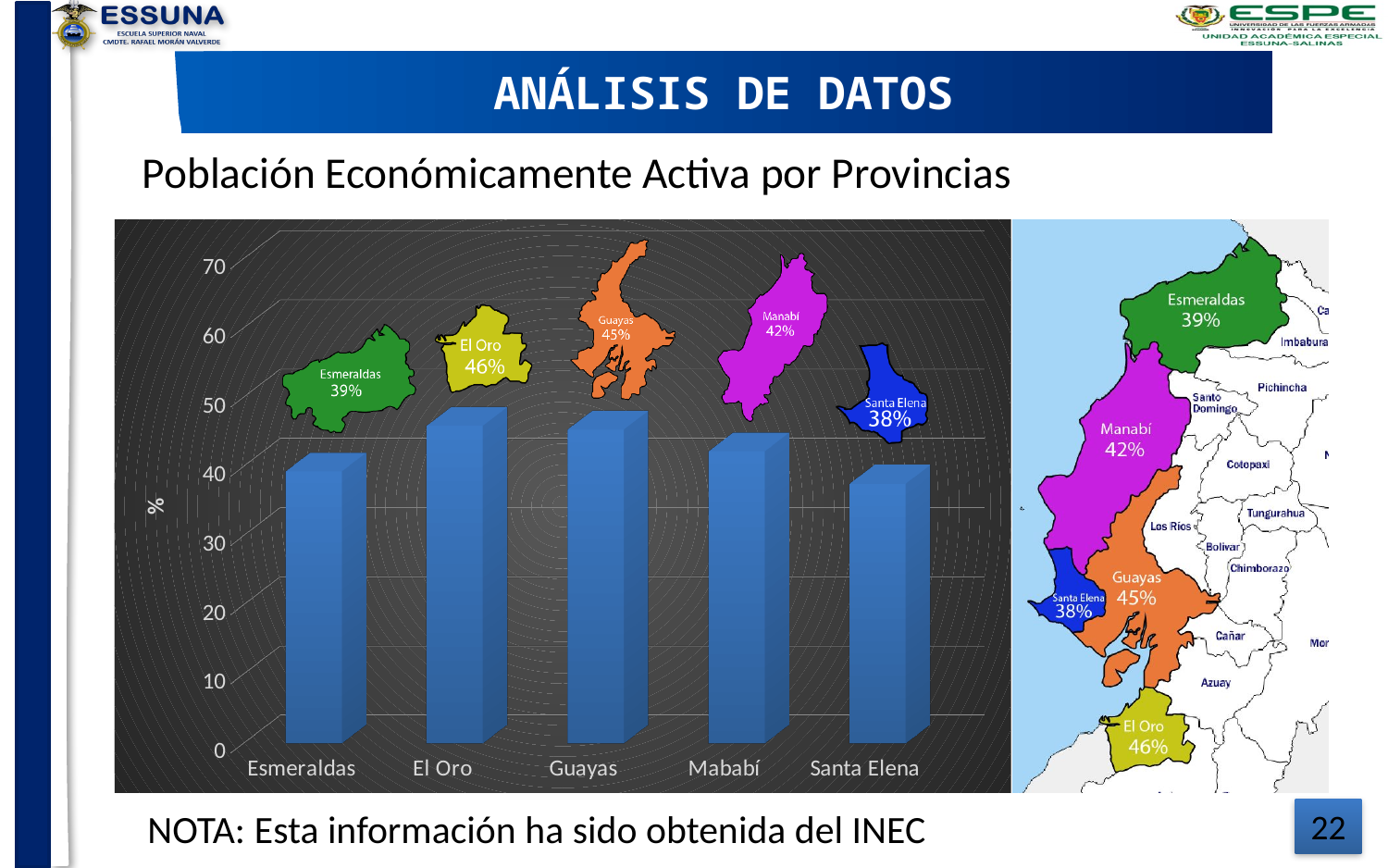
Is the value for Esmeraldas greater or less than 30? greater What is the value for Guayas? 45% What is the value for El Oro? 46% Which province has the lowest value on the chart? Santa Elena Which province has the highest value on the chart? El Oro What is the value for Esmeraldas? 39% What is the value for Santa Elena? 38% What is the difference between the values for El Oro and Santa Elena? 8 percentage points What kind of chart is shown on the slide? Bar chart What is the title shown above the chart? Población Económicamente Activa por Provincias How many provinces are plotted on the bar chart? 5 Which is larger, the value for Guayas or the value for Esmeraldas? Guayas